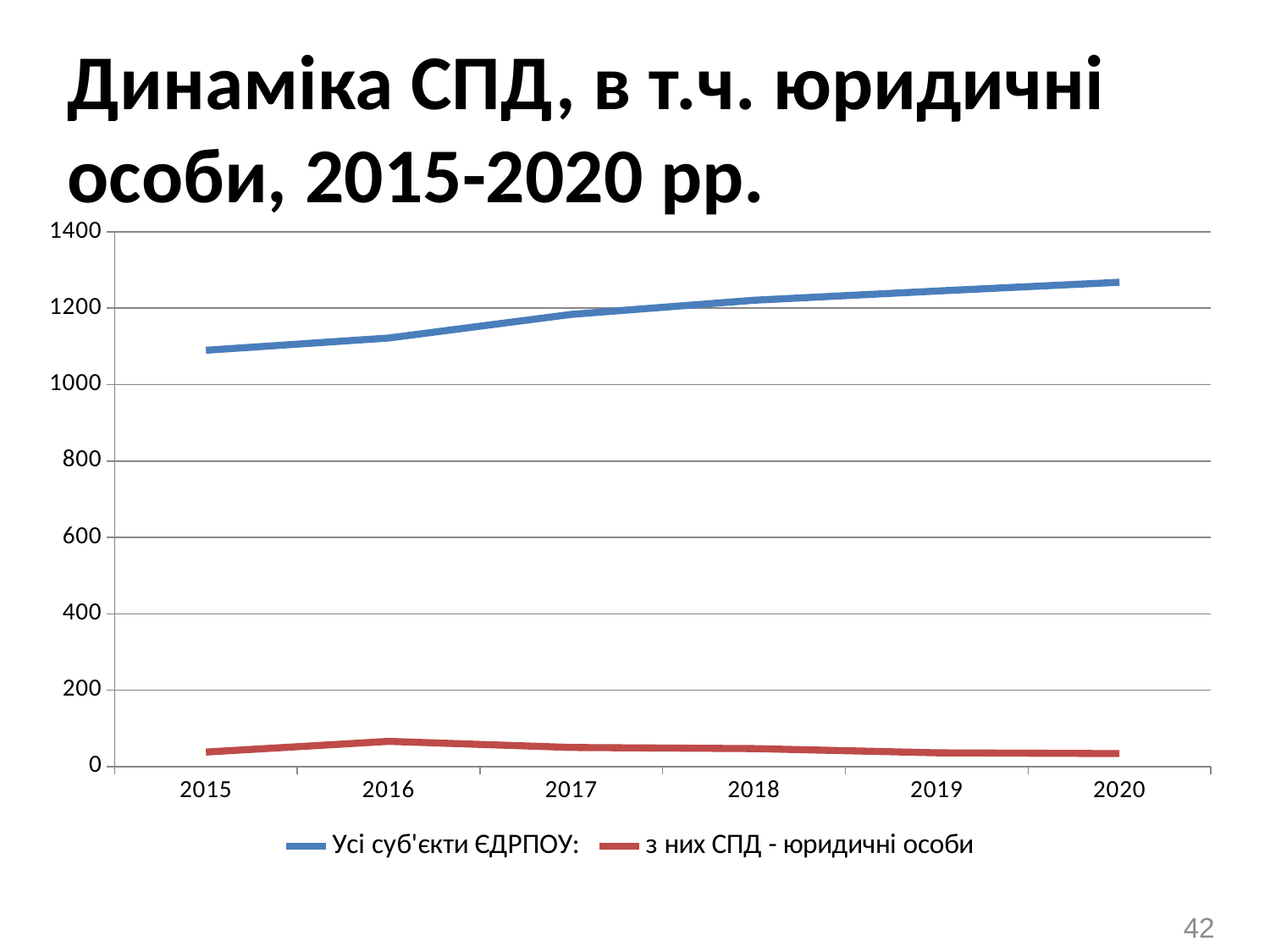
What kind of chart is shown on the slide? line chart In which year is the value for 'Усі суб'єкти ЄДРПОУ:' highest? 2020 Does the series 'Усі суб'єкти ЄДРПОУ:' rise or fall from 2015 to 2020? rise In which year is the value for 'Усі суб'єкти ЄДРПОУ:' lowest? 2015 In which year is the value for 'з них СПД - юридичні особи' highest? 2016 Is the value for 'з них СПД - юридичні особи' in 2016 greater or less than 200? less How many years are plotted along the x axis? 6 Is the value for 'Усі суб'єкти ЄДРПОУ:' in 2015 greater or less than 1000? greater How many series does the legend list? 2 What colour is the line for 'з них СПД - юридичні особи'? red Which series has the larger value in 2018, 'Усі суб'єкти ЄДРПОУ:' or 'з них СПД - юридичні особи'? Усі суб'єкти ЄДРПОУ: Is the value for 'Усі суб'єкти ЄДРПОУ:' in 2020 greater or less than 1200? greater